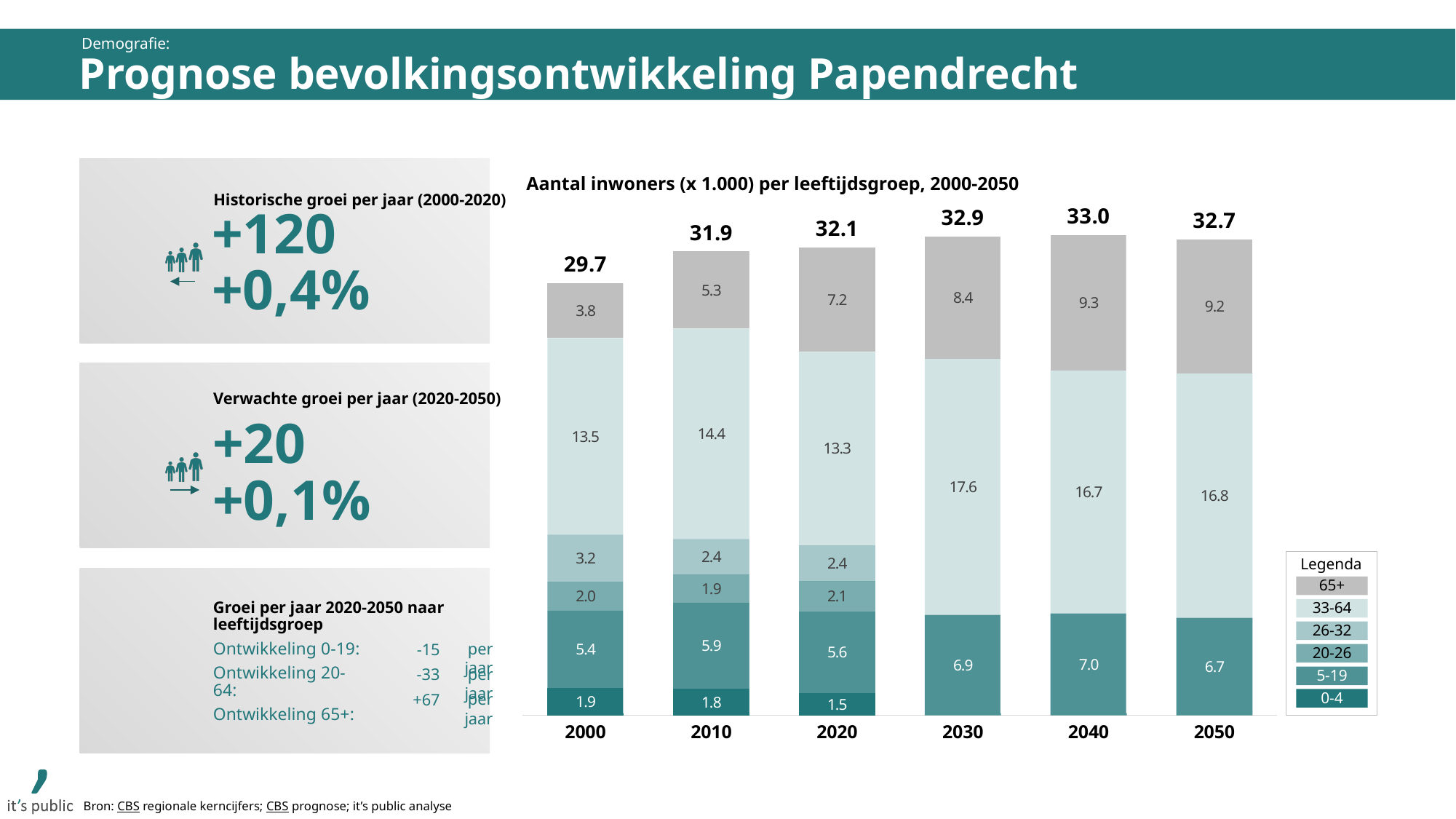
What is the total of the stacked bar for 2030? 32.9 Which is larger: the 5-19 value in 2010 or the 5-19 value in 2000? 2010 What is the value for the 65+ age group in 2000? 3.8 Which year has the lowest total number of inhabitants? 2000 How many years are shown on the x axis? 6 What is the value for the 33-64 age group in 2010? 14.4 What is the difference between the 65+ value in 2020 and the 65+ value in 2000? 3.4 What is the value for the 65+ age group in 2050? 9.2 What kind of chart is shown on the slide? Stacked bar chart Which year has the highest total number of inhabitants? 2040 What is the value for the 0-4 age group in 2020? 1.5 How many age groups does the legend list? 6